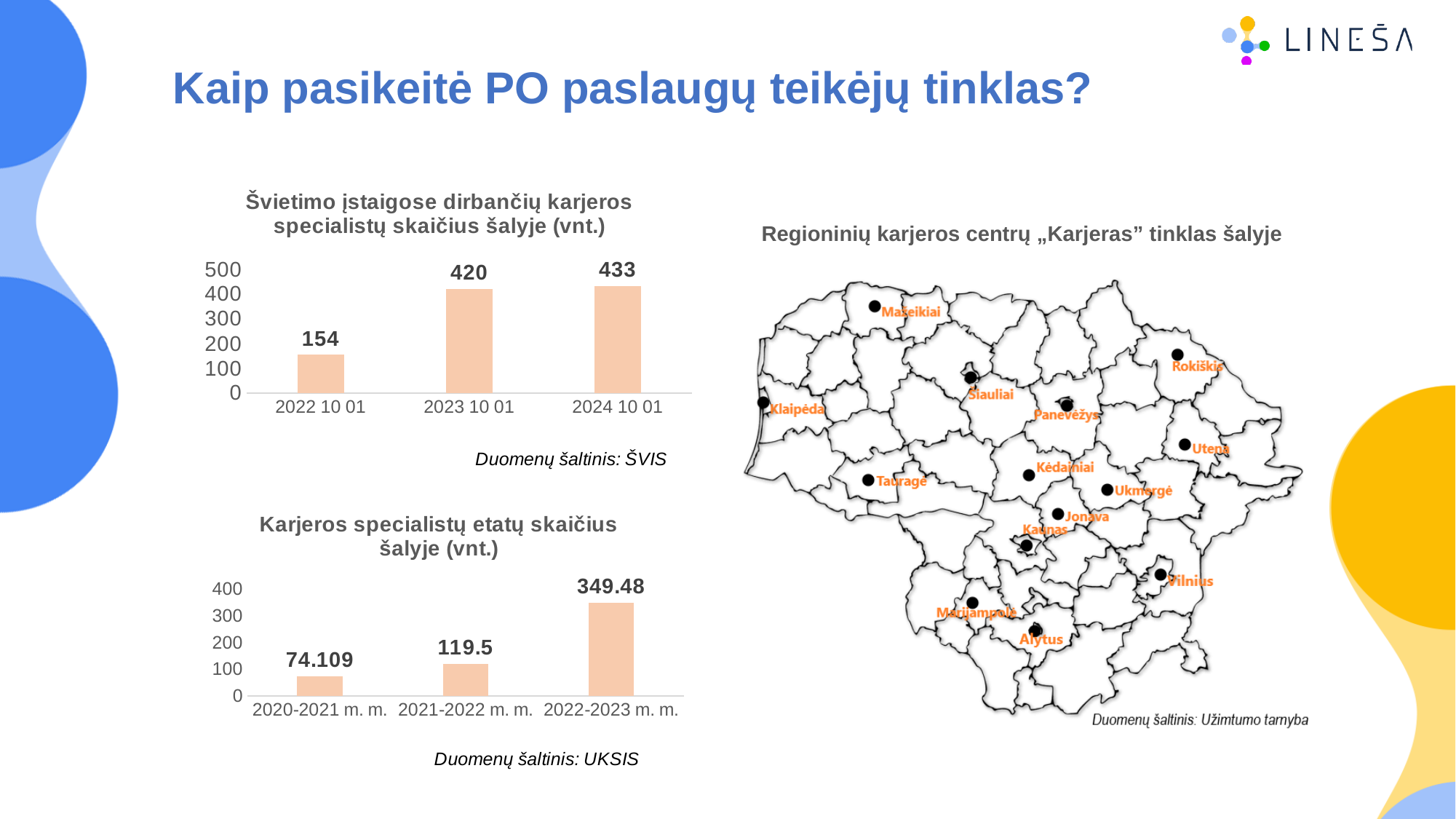
In the top chart (Švietimo įstaigose dirbančių karjeros specialistų skaičius šalyje), what is the difference between the values for 2024 10 01 and 2022 10 01? 279 In the top chart (Švietimo įstaigose dirbančių karjeros specialistų skaičius šalyje), what is the value for 2022 10 01? 154 In the top chart (Švietimo įstaigose dirbančių karjeros specialistų skaičius šalyje), which date has the lowest value? 2022 10 01 In the top chart (Švietimo įstaigose dirbančių karjeros specialistų skaičius šalyje), how many dates are shown on the x axis? 3 In the top chart (Švietimo įstaigose dirbančių karjeros specialistų skaičius šalyje), what is the value for 2024 10 01? 433 In the bottom chart (Karjeros specialistų etatų skaičius šalyje), which is larger: the value for 2021-2022 m. m. or for 2020-2021 m. m.? 2021-2022 m. m. In the bottom chart (Karjeros specialistų etatų skaičius šalyje), which school year has the highest value? 2022-2023 m. m. In the top chart (Švietimo įstaigose dirbančių karjeros specialistų skaičius šalyje), do the values rise or fall from 2022 10 01 to 2024 10 01? rise What kind of chart is the bottom chart (Karjeros specialistų etatų skaičius šalyje)? bar chart What data source is cited below the top chart (Švietimo įstaigose dirbančių karjeros specialistų skaičius šalyje)? ŠVIS In the bottom chart (Karjeros specialistų etatų skaičius šalyje), what is the value for 2020-2021 m. m.? 74.109 In the bottom chart (Karjeros specialistų etatų skaičius šalyje), what is the value for 2022-2023 m. m.? 349.48